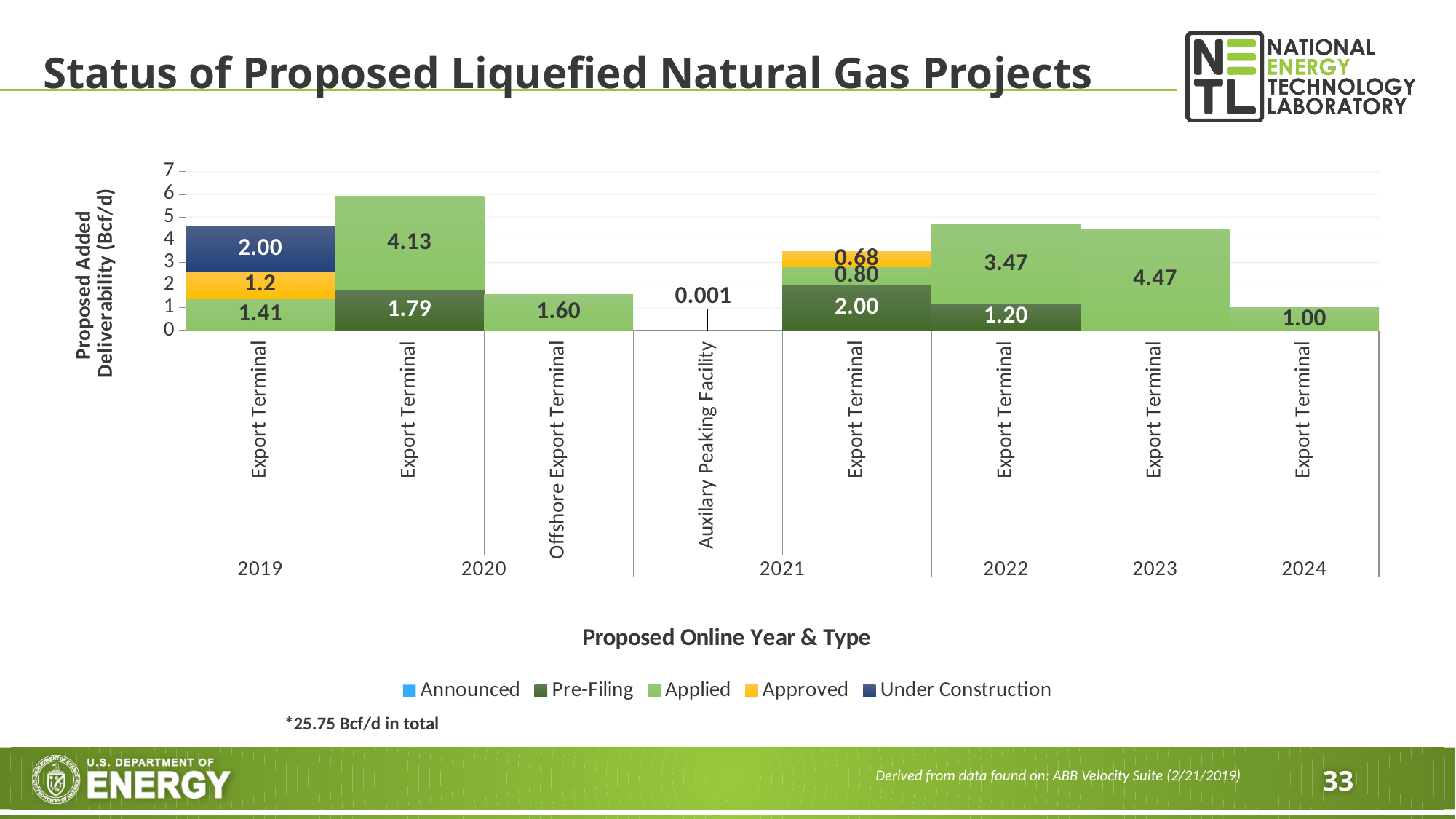
What is the Approved value for the 2021 Export Terminal bar? 0.68 What kind of chart is shown on the slide? Stacked bar chart What is the value shown for the 2021 Auxilary Peaking Facility? 0.001 Which category has the smallest total value? 2021 Auxilary Peaking Facility What is the total of the stacked bar for the 2019 Export Terminal? 4.61 What is the Applied value for the 2020 Export Terminal bar? 4.13 Which is larger: the Pre-Filing value for the 2021 Export Terminal or the Pre-Filing value for the 2022 Export Terminal? 2021 Export Terminal Which category has the tallest stacked bar? 2020 Export Terminal What is the Under Construction value for the 2019 Export Terminal bar? 2.00 What is the total of the stacked bar for the 2022 Export Terminal? 4.67 How many series does the legend list? 5 What is the difference between the Applied value for the 2023 Export Terminal and the Applied value for the 2024 Export Terminal? 3.47